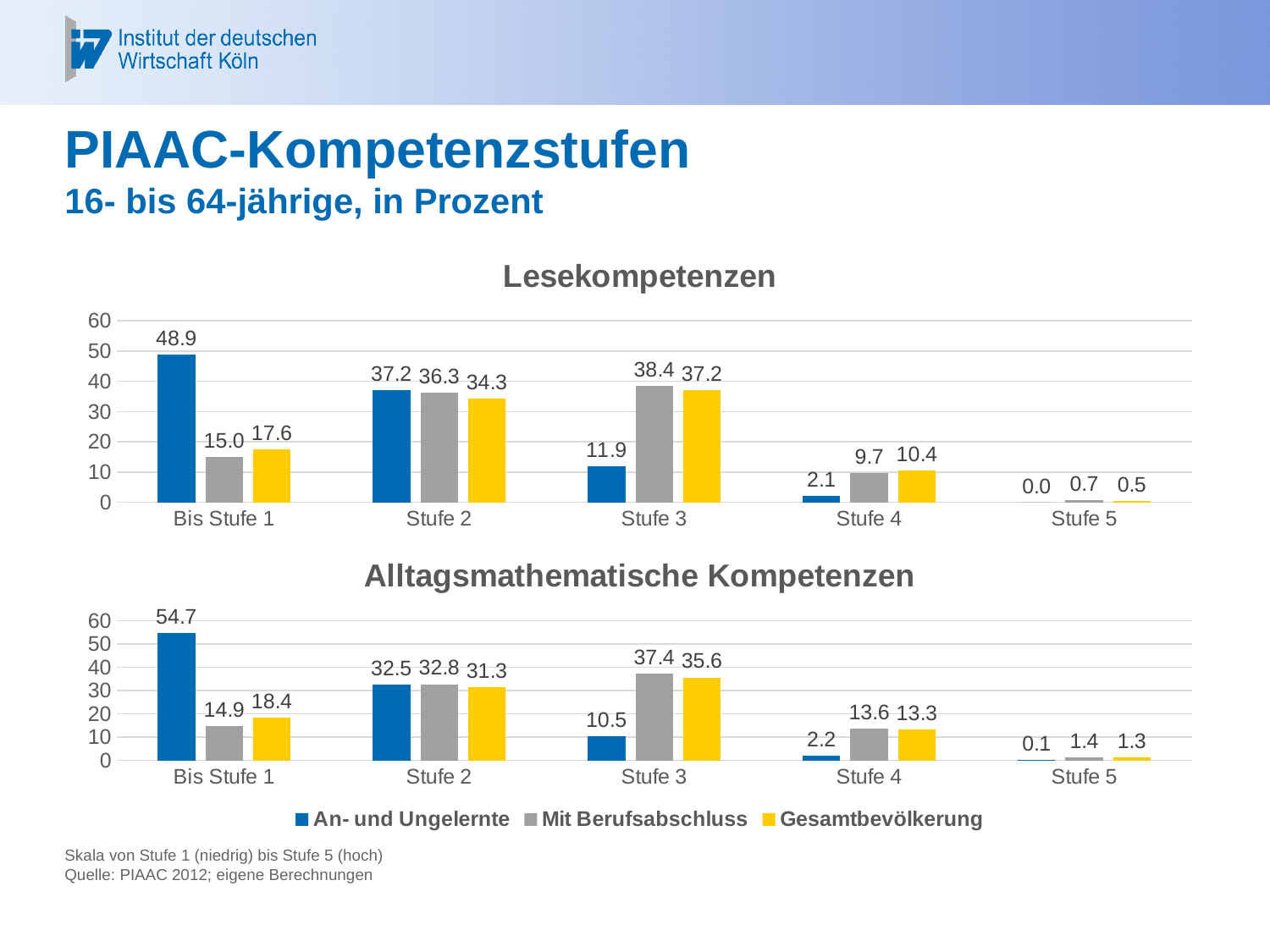
In the Lesekompetenzen chart, which category has the highest value for Mit Berufsabschluss? Stufe 3 In the Alltagsmathematische Kompetenzen chart, do the values for An- und Ungelernte rise or fall from Bis Stufe 1 to Stufe 5? Fall In the Lesekompetenzen chart, what is the value for An- und Ungelernte at Bis Stufe 1? 48.9 In the Lesekompetenzen chart, what is the difference between An- und Ungelernte and Gesamtbevölkerung at Bis Stufe 1? 31.3 Which series is shown in yellow in the legend? Gesamtbevölkerung How many series does the legend list? 3 What kind of chart is the Lesekompetenzen chart? Bar chart In the Alltagsmathematische Kompetenzen chart, what is the value for Gesamtbevölkerung at Stufe 4? 13.3 In the Lesekompetenzen chart, is the value for Gesamtbevölkerung at Stufe 2 greater or less than 30? greater In the Alltagsmathematische Kompetenzen chart, which category has the lowest value for An- und Ungelernte? Stufe 5 In the Alltagsmathematische Kompetenzen chart, which is larger at Stufe 3: Mit Berufsabschluss or An- und Ungelernte? Mit Berufsabschluss How many categories are shown on the x axis of the Alltagsmathematische Kompetenzen chart? 5